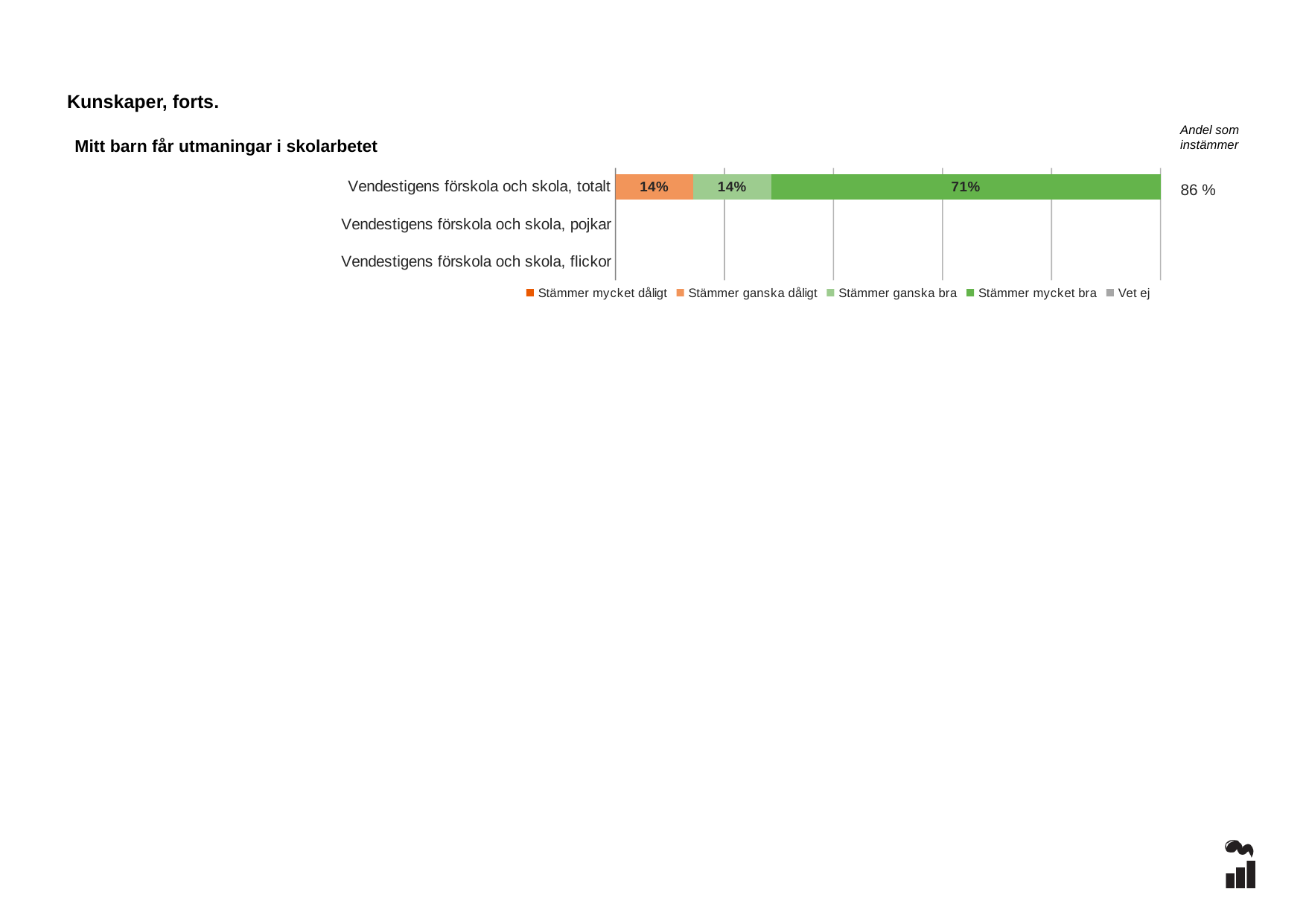
Which legend entry is shown in dark green? Stämmer mycket bra How many categories are listed on the vertical axis of the chart? 3 What is the value of the 'Stämmer mycket bra' segment for 'Vendestigens förskola och skola, totalt'? 71% What kind of chart is shown on the slide? Stacked bar chart Which segment is the largest in the bar for 'Vendestigens förskola och skola, totalt'? Stämmer mycket bra What is the title of the chart? Mitt barn får utmaningar i skolarbetet What is the 'Andel som instämmer' value shown for 'Vendestigens förskola och skola, totalt'? 86 % What is the difference between the 'Stämmer mycket bra' and 'Stämmer ganska bra' segments for 'Vendestigens förskola och skola, totalt'? 57% How many series does the legend list? 5 What is the value of the 'Stämmer ganska dåligt' segment for 'Vendestigens förskola och skola, totalt'? 14% What is the value of the 'Stämmer ganska bra' segment for 'Vendestigens förskola och skola, totalt'? 14% Which is larger for 'Vendestigens förskola och skola, totalt': the 'Stämmer mycket bra' segment or the 'Stämmer ganska dåligt' segment? Stämmer mycket bra